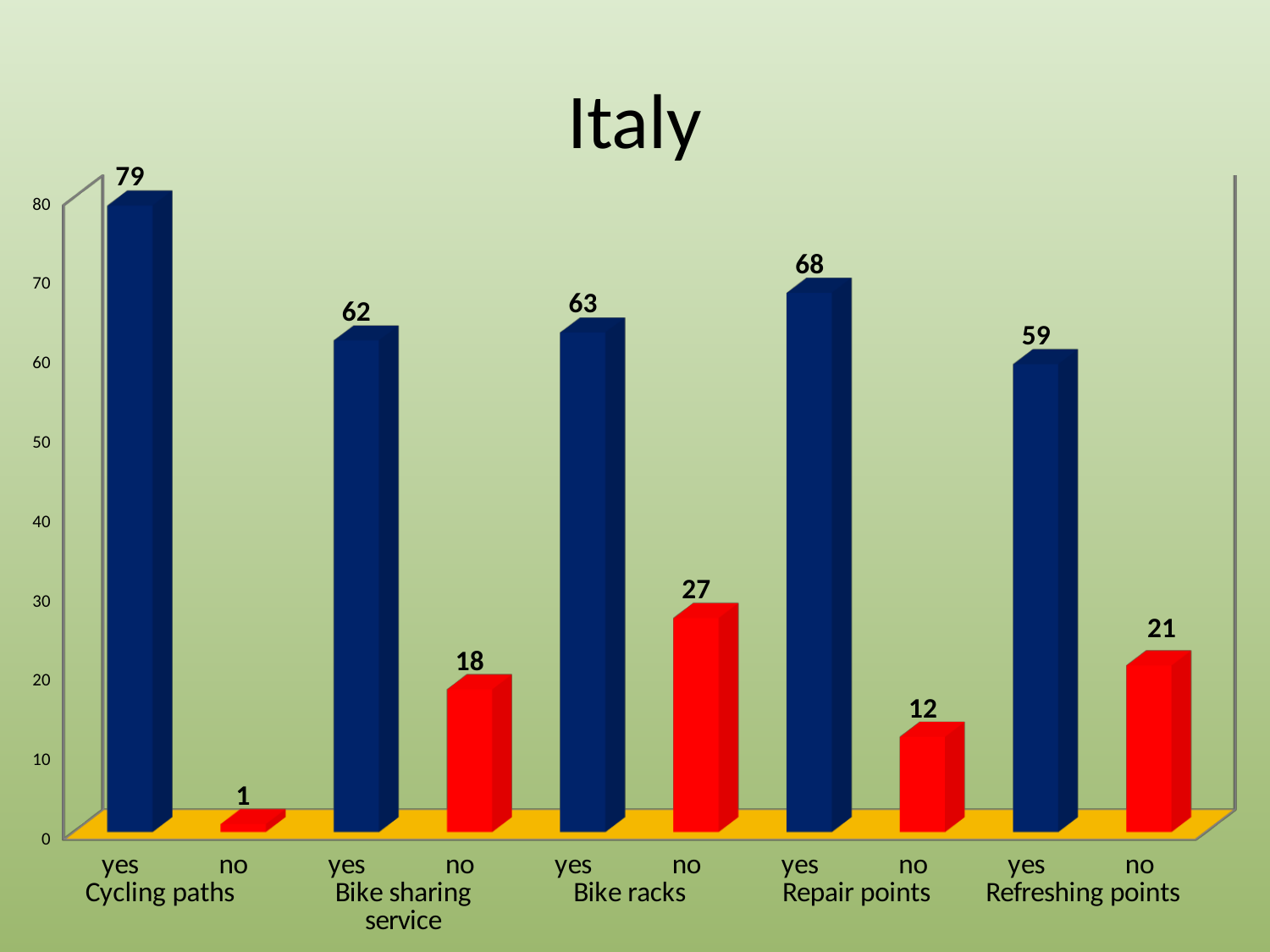
How many bars are plotted on the chart? 10 How many category groups are shown on the x axis? 5 What is the value for 'yes' under Refreshing points? 59 Which bar has the lowest value on the chart? no, Cycling paths What is the difference between the 'yes' and 'no' values for Bike sharing service? 44 Which bar has the highest value on the chart? yes, Cycling paths What is the value for 'yes' under Cycling paths? 79 What is the title of the chart? Italy What is the value for 'no' under Repair points? 12 What is the value for 'no' under Bike racks? 27 Which is larger: the 'no' value for Bike racks or the 'no' value for Refreshing points? no, Bike racks What kind of chart is shown on the slide? bar chart